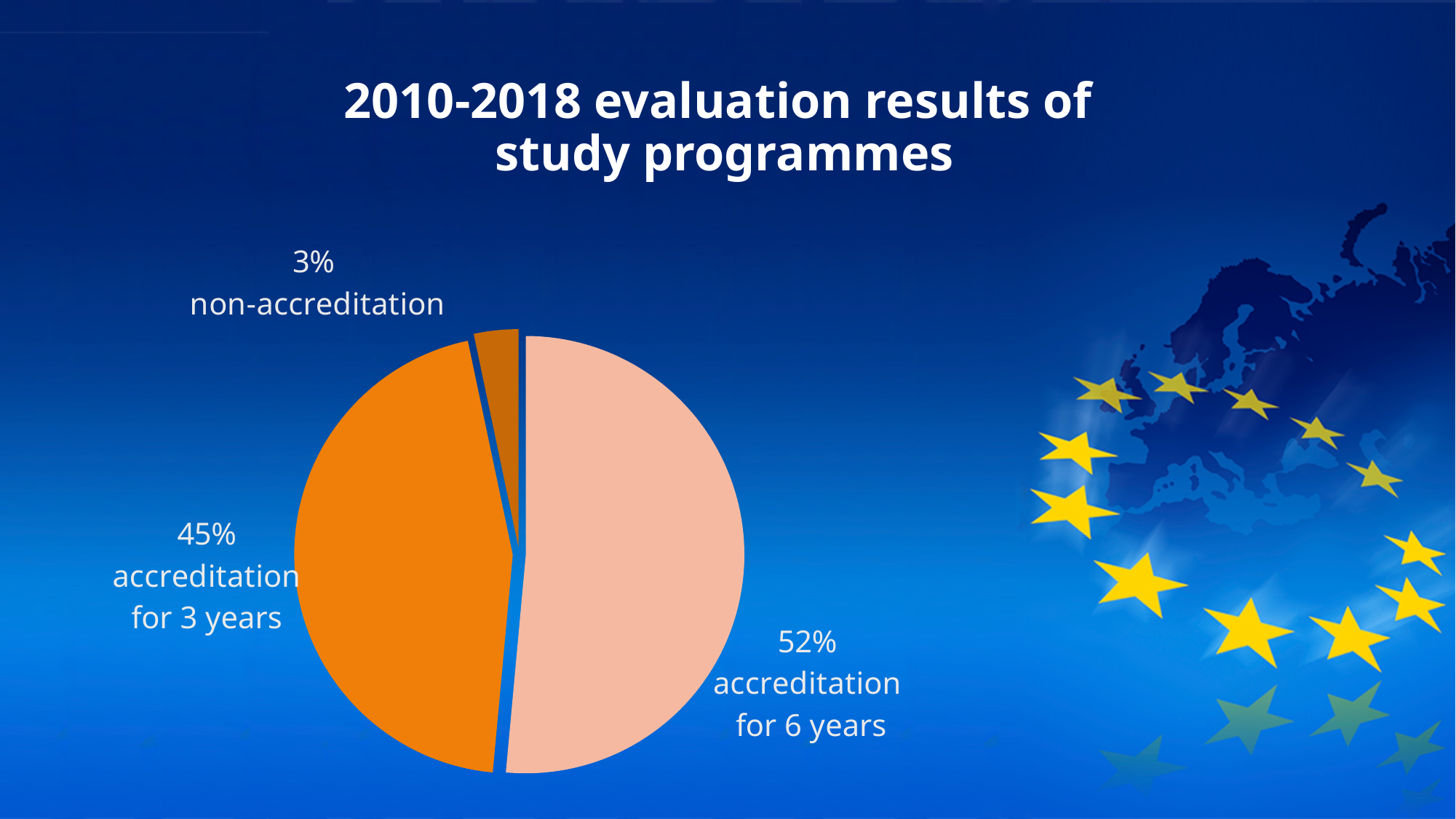
Which evaluation outcome has the smallest share of the pie? non-accreditation What is the title of the slide containing the chart? 2010-2018 evaluation results of study programmes What kind of chart is shown on the slide? pie chart What is the difference in percentage points between accreditation for 6 years and accreditation for 3 years? 7 Which is larger: the share for accreditation for 6 years or the share for accreditation for 3 years? accreditation for 6 years Which evaluation outcome has the largest share of the pie? accreditation for 6 years What share of study programmes received accreditation for 3 years? 45% What share of study programmes received accreditation for 6 years? 52% How many slices does the pie chart have? 3 What is the difference in percentage points between accreditation for 3 years and non-accreditation? 42 What colour is the slice for accreditation for 6 years? light pink What share of study programmes received non-accreditation? 3%